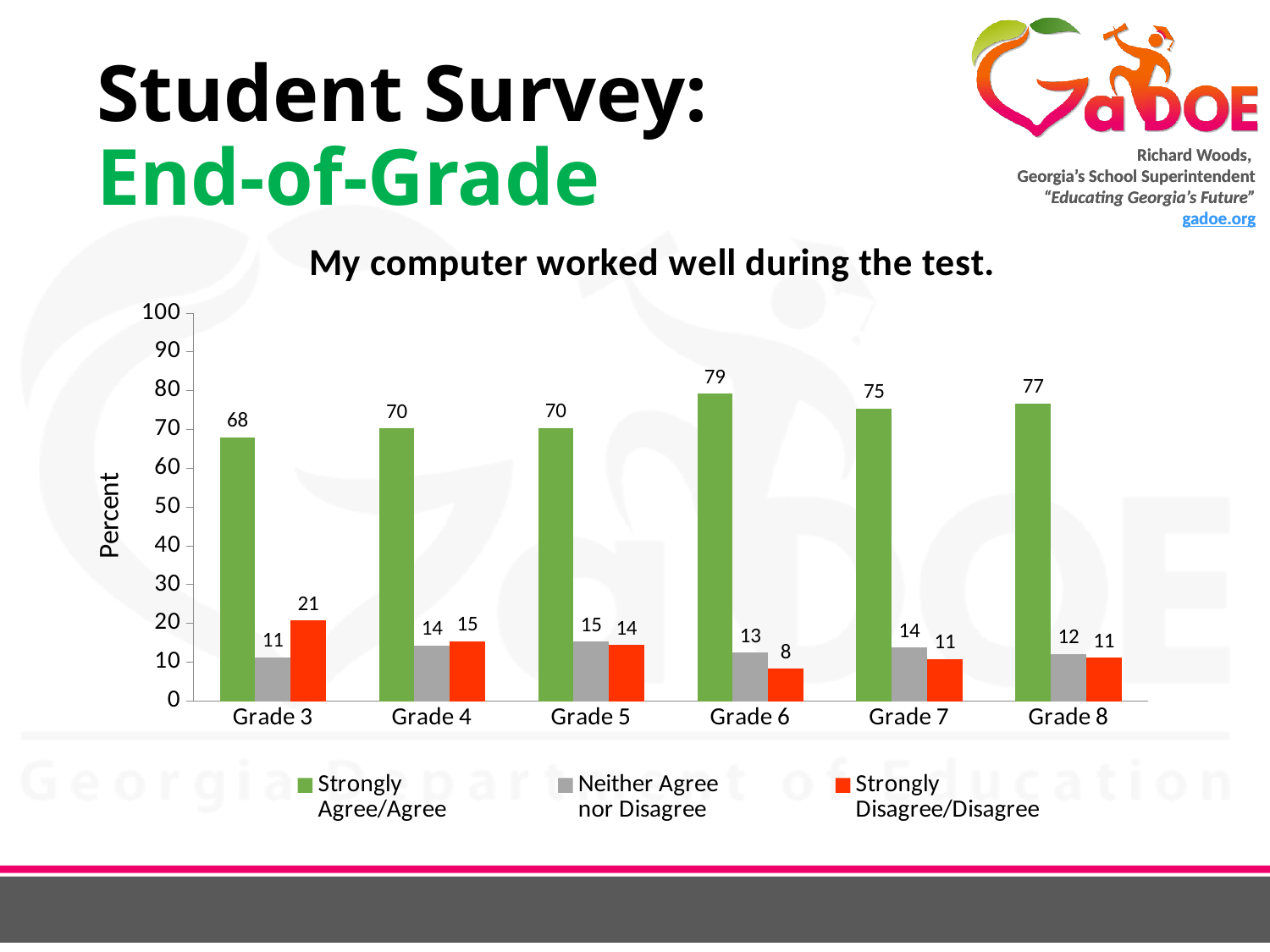
Which is larger, the Strongly Disagree/Disagree value for Grade 3 or for Grade 4? Grade 3 What kind of chart is shown on the slide? bar chart What is the Strongly Disagree/Disagree value for Grade 3? 21 How many grades are shown on the x axis? 6 Is the Strongly Agree/Agree value for Grade 7 greater or less than 60? greater Which grade has the lowest Strongly Disagree/Disagree value? Grade 6 What is the difference between the Strongly Agree/Agree values for Grade 6 and Grade 3? 11 What is the Neither Agree nor Disagree value for Grade 5? 15 What is the title of the chart? My computer worked well during the test. What is the Strongly Agree/Agree value for Grade 6? 79 How many series does the legend list? 3 Which grade has the highest Strongly Agree/Agree value? Grade 6